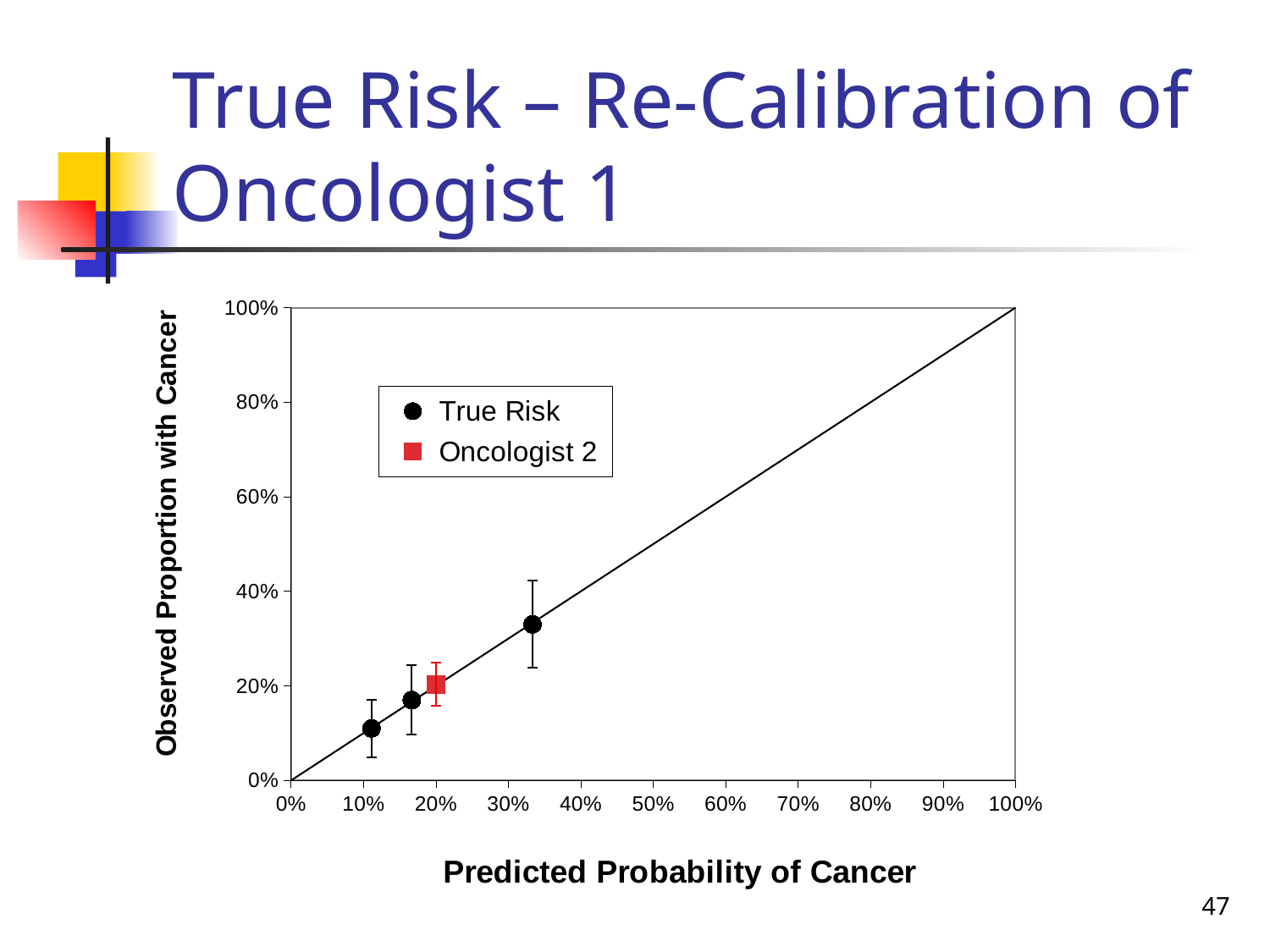
What is the title of the x axis? Predicted Probability of Cancer Do the True Risk points rise or fall as the predicted probability increases along the x axis? rise Which has the higher observed proportion: the Oncologist 2 point or the rightmost True Risk point? The rightmost True Risk point What are the two series named in the legend? True Risk and Oncologist 2 How many True Risk data points are plotted? 3 How many Oncologist 2 data points are plotted? 1 What kind of chart is shown on the slide? Scatter chart How many series does the legend list? 2 Is the observed proportion for the lowest True Risk point greater or less than 20%? less Is the observed proportion for the highest True Risk point greater or less than 60%? less Is the observed proportion for the Oncologist 2 point greater or less than 40%? less